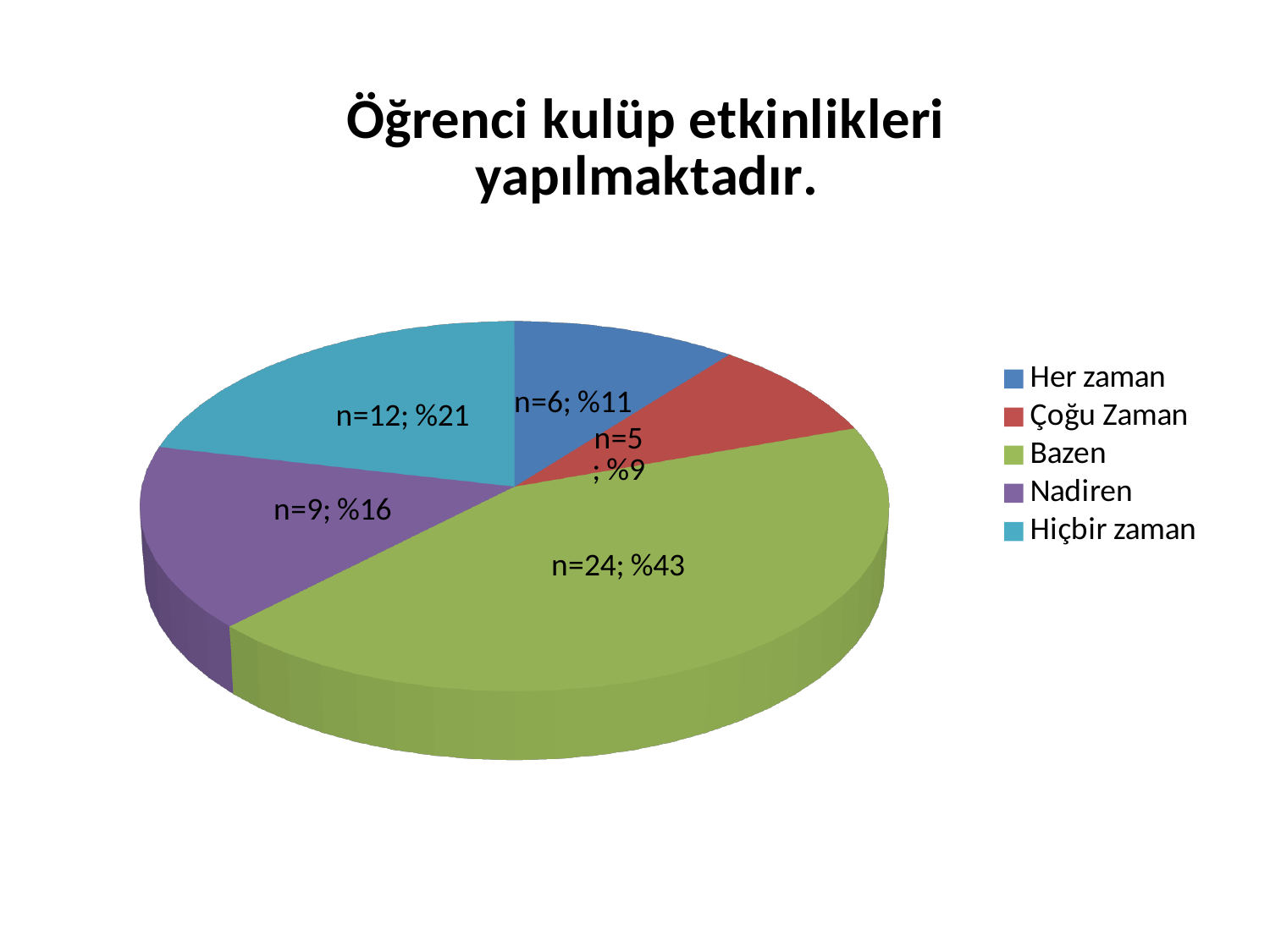
Which category has the smallest slice? Çoğu Zaman What percentage share does the Her zaman slice have? %11 What is the count (n) for the Nadiren slice? n=9 What kind of chart is shown on the slide? Pie chart What is the title of the chart? Öğrenci kulüp etkinlikleri yapılmaktadır. Which has a larger count, Nadiren or Her zaman? Nadiren What is the difference in count (n) between Bazen and Hiçbir zaman? 12 What is the count (n) for the Çoğu Zaman slice? n=5 What is the count (n) for the Bazen slice? n=24 How many categories does the legend list? 5 Which category has the largest slice? Bazen What percentage share does the Hiçbir zaman slice have? %21